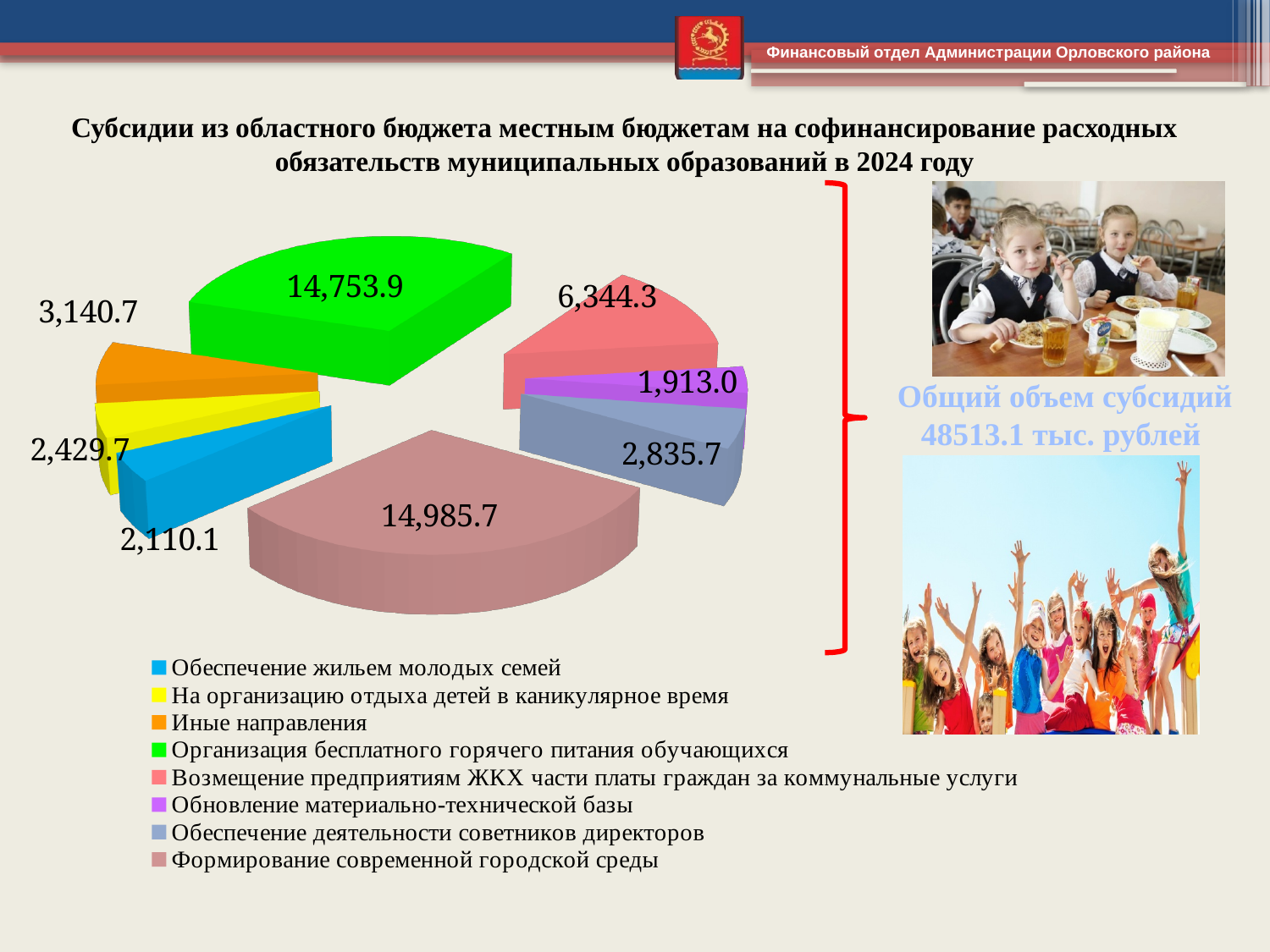
What is the value for "Обновление материально-технической базы"? 1,913.0 What is the value for "Обеспечение жильем молодых семей"? 2,110.1 How many entries does the legend list? 8 Which category has the smallest value? Обновление материально-технической базы Which is larger: "Иные направления" or "На организацию отдыха детей в каникулярное время"? Иные направления What is the value for "Организация бесплатного горячего питания обучающихся"? 14,753.9 What is the value for "Возмещение предприятиям ЖКХ части платы граждан за коммунальные услуги"? 6,344.3 What total volume of subsidies is stated on the slide? 48513.1 тыс. рублей What type of chart is shown on the slide? Pie chart Which category has the largest value? Формирование современной городской среды How many slices does the pie chart have? 8 What is the difference between "Формирование современной городской среды" and "Организация бесплатного горячего питания обучающихся"? 231.8